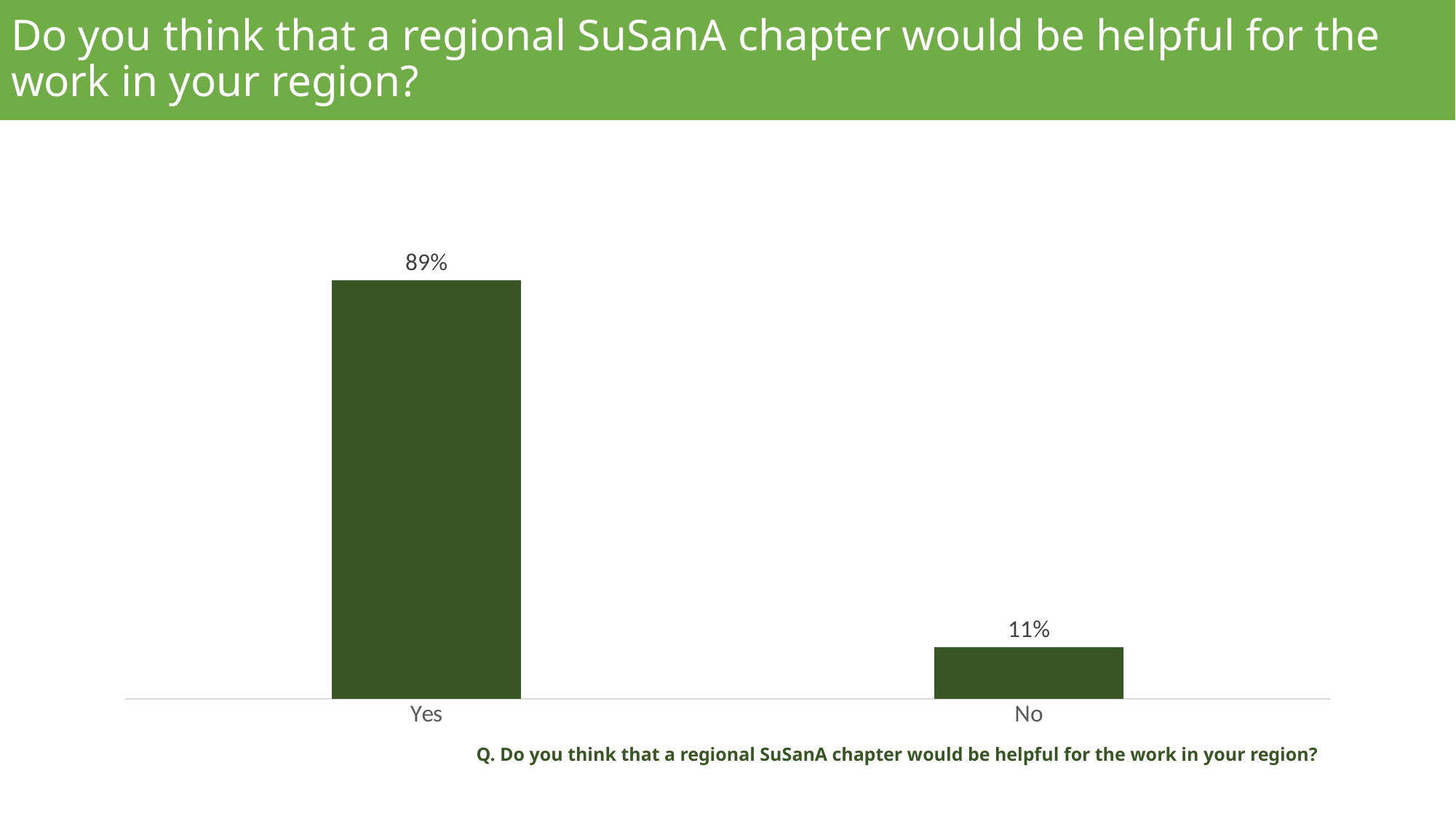
How many response categories are shown on the chart? 2 Which is larger, the value for Yes or the value for No? Yes What is the total of the Yes and No percentages? 100% Which response has the highest value? Yes What question does the chart's caption say the data answers? Do you think that a regional SuSanA chapter would be helpful for the work in your region? What percentage of respondents answered No? 11% What is the difference between the Yes and No percentages? 78% Which response has the lowest value? No What kind of chart is shown on the slide? Bar chart What colour are the bars in the chart? Dark green What percentage of respondents answered Yes? 89%